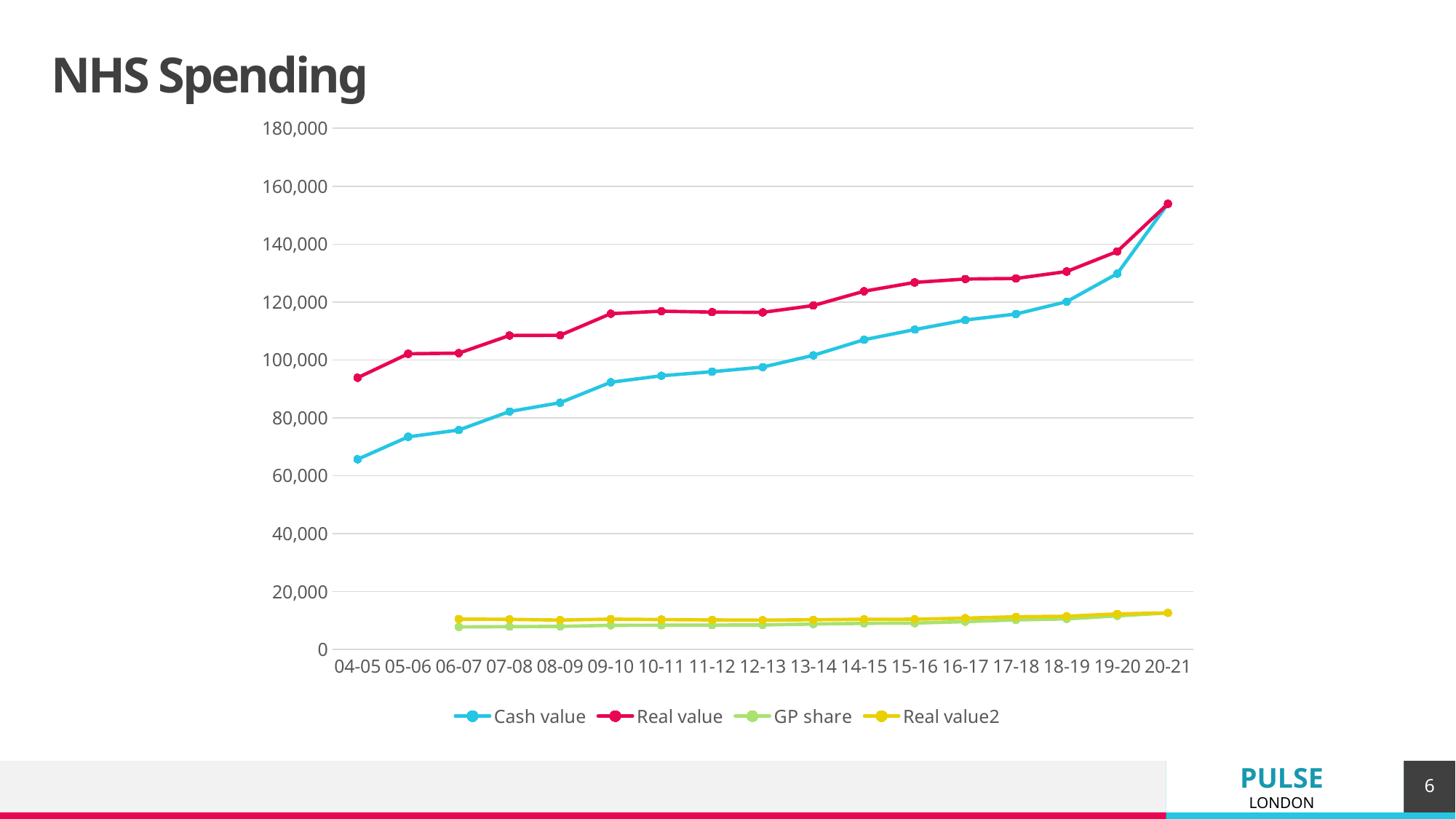
How many series does the legend list? 4 Does the Cash value series rise or fall from 04-05 to 20-21? Rise What is the title of the slide? NHS Spending In which year is the Cash value series at its highest? 20-21 In which year is the Real value series at its lowest? 04-05 What kind of chart is shown on the slide? Line chart Which series is drawn in red? Real value In 10-11, which is larger: the Real value or the Cash value? Real value Is the Cash value for 04-05 greater or less than 80,000? less Is the Real value for 20-21 greater or less than 140,000? greater Is the Cash value for 19-20 greater or less than 120,000? greater How many financial years are shown along the x axis? 17